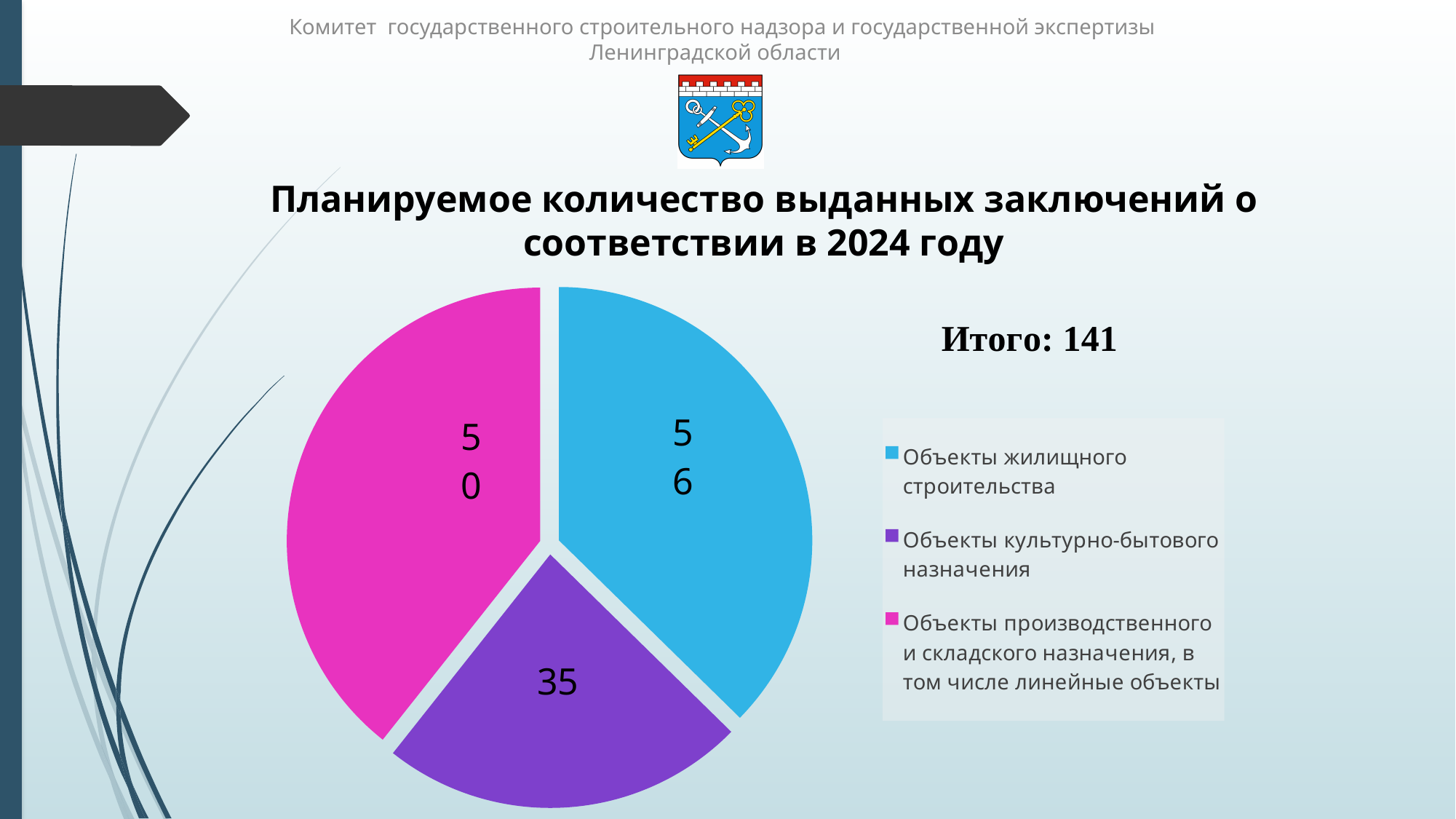
What is the value for Объекты культурно-бытового назначения? 35 How many categories does the pie chart have? 3 What colour is the slice for Объекты культурно-бытового назначения? purple What is the value for Объекты жилищного строительства? 56 What total is stated on the slide next to the pie chart (Итого)? 141 What is the value for Объекты производственного и складского назначения, в том числе линейные объекты? 50 What kind of chart is shown on the slide? pie chart What is the difference between the values for Объекты жилищного строительства and Объекты культурно-бытового назначения? 21 Which category has the smallest slice of the pie? Объекты культурно-бытового назначения What is the difference between the values for Объекты производственного и складского назначения and Объекты культурно-бытового назначения? 15 Which is larger: the value for Объекты жилищного строительства or the value for Объекты производственного и складского назначения? Объекты жилищного строительства